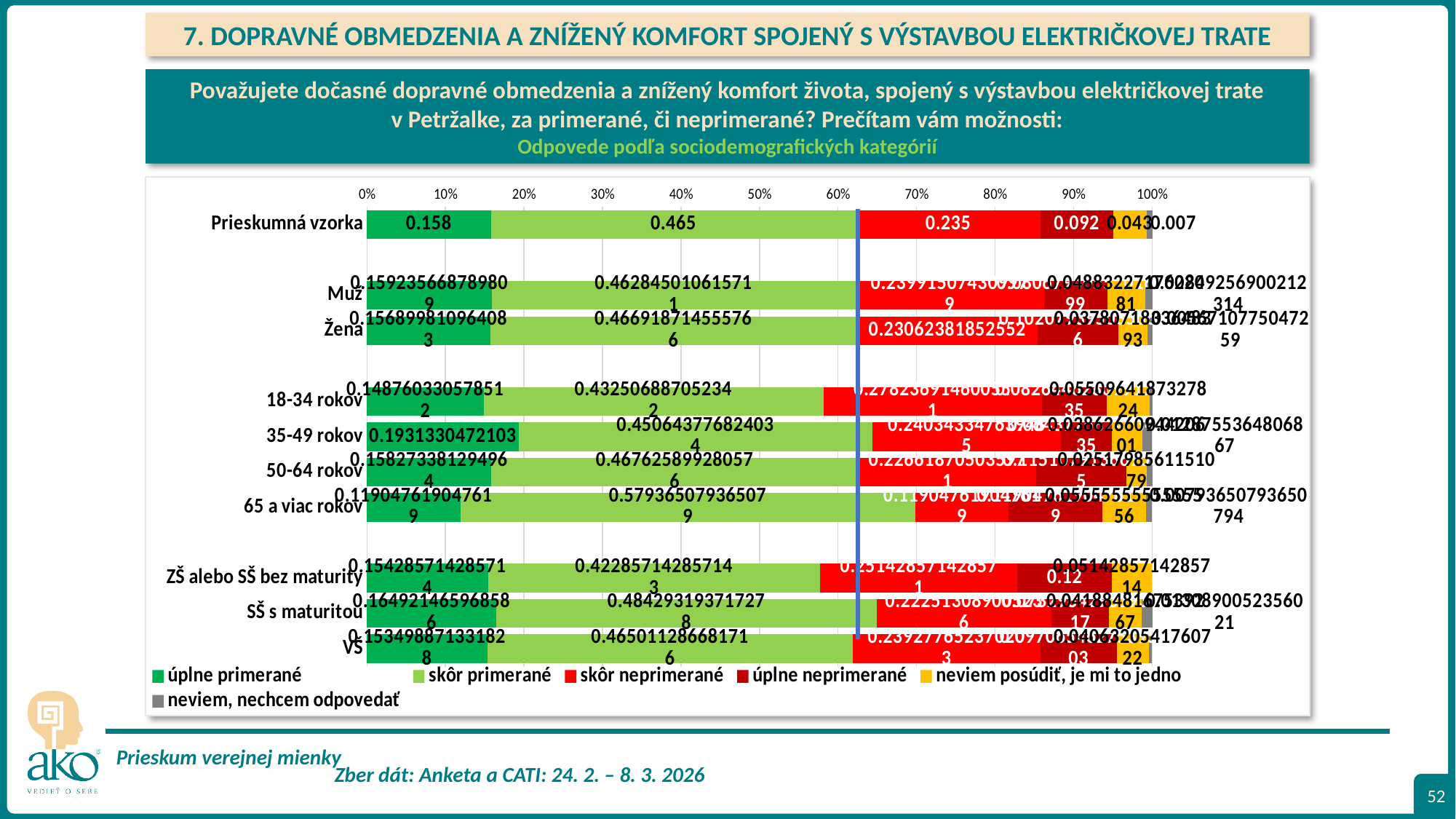
Is the value of 'úplne primerané' for '65 a viac rokov' greater or less than 20%? less What kind of chart is shown on the slide? stacked bar chart What is the value of 'úplne neprimerané' for 'ZŠ alebo SŠ bez maturity'? 0.12 How many series does the legend list? 6 What is the value of 'úplne neprimerané' for 'Prieskumná vzorka'? 0.092 What is the value of 'skôr neprimerané' for 'Prieskumná vzorka'? 0.235 How many categories (rows) are plotted in the chart? 10 Which series has the largest value in the 'Prieskumná vzorka' row? skôr primerané Which has the larger 'skôr primerané' value: '65 a viac rokov' or 'Prieskumná vzorka'? 65 a viac rokov What is the value of 'úplne primerané' for 'Prieskumná vzorka'? 0.158 What is the difference between 'skôr primerané' and 'skôr neprimerané' for 'Prieskumná vzorka'? 0.230 What is the value of 'skôr primerané' for 'Prieskumná vzorka'? 0.465